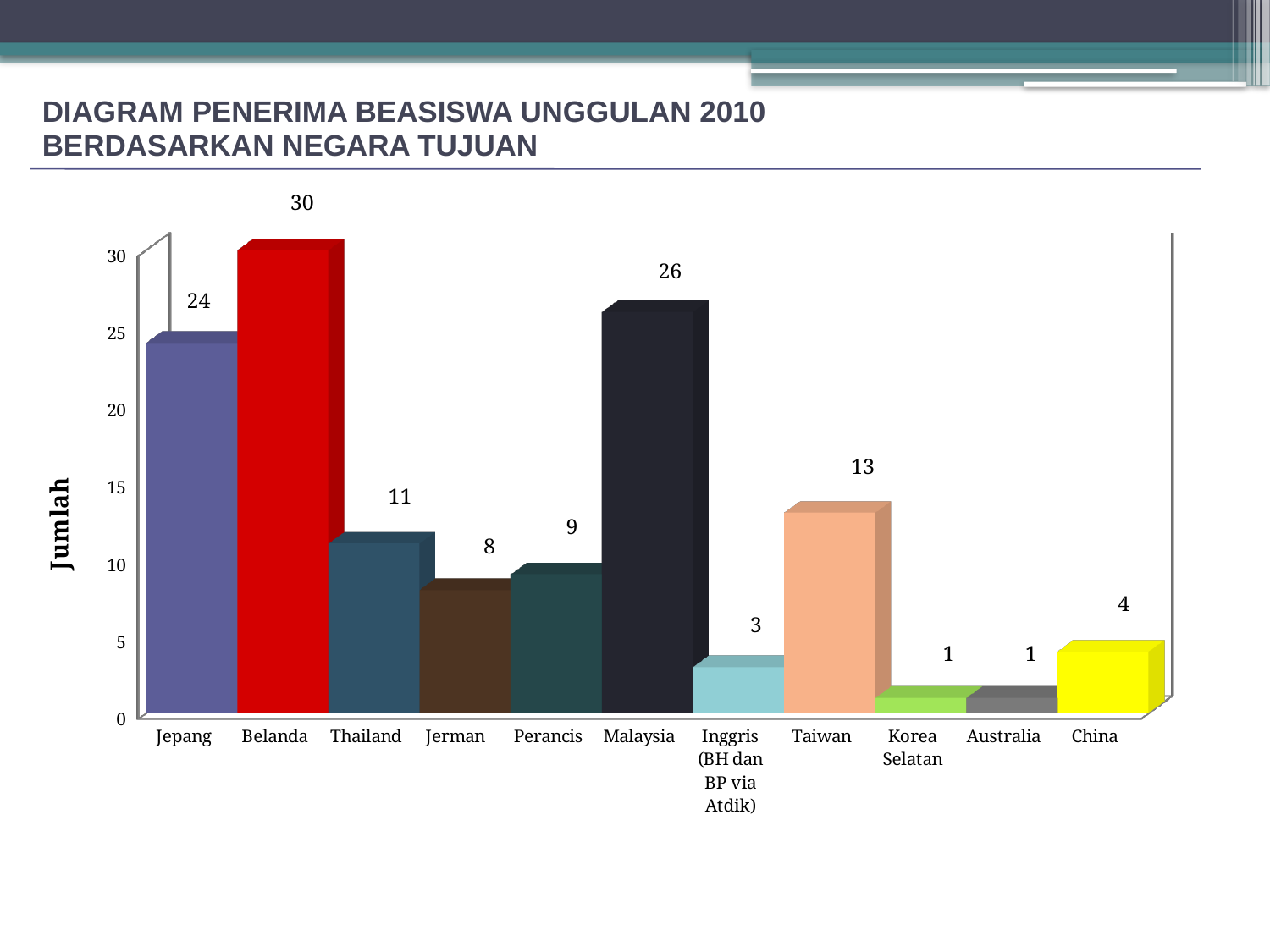
What colour is the bar for China? yellow What is the difference between the values for Taiwan and China? 9 What is the value for Jepang? 24 What kind of chart is shown on the slide? bar chart Is the value for Malaysia greater or less than 25? greater How many countries are shown on the x axis? 11 What is the difference between the values for Belanda and Jepang? 6 Which is larger, the value for Thailand or the value for Perancis? Thailand What is the value for Taiwan? 13 What is the value for Malaysia? 26 What is the label of the y axis? Jumlah Which country has the highest value? Belanda